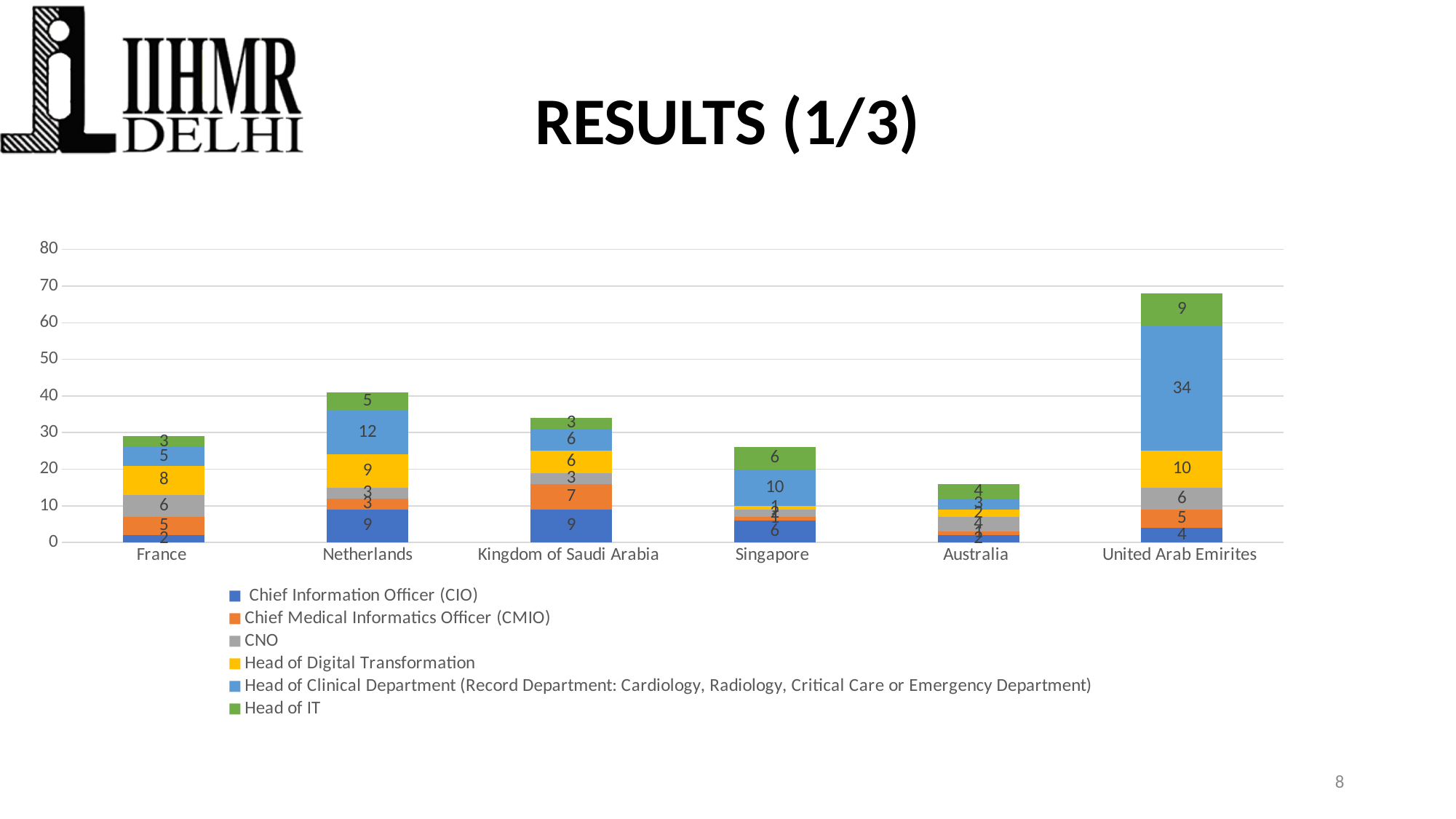
How many countries are shown on the x axis? 6 What is the total of the stacked bar for Netherlands? 41 Which is larger: the Chief Information Officer (CIO) value for Netherlands or for France? Netherlands Which country has the highest value for Head of Clinical Department? United Arab Emirites What is the value for Chief Medical Informatics Officer (CMIO) in Kingdom of Saudi Arabia? 7 What is the value for Head of IT in Netherlands? 5 How many series does the legend list? 6 What is the value for Head of Clinical Department in United Arab Emirites? 34 What is the total of the stacked bar for United Arab Emirites? 68 Is the total for the Australia bar greater or less than 20? less What is the value for Head of Digital Transformation in France? 8 What is the difference between the Head of Clinical Department values for Netherlands and Kingdom of Saudi Arabia? 6